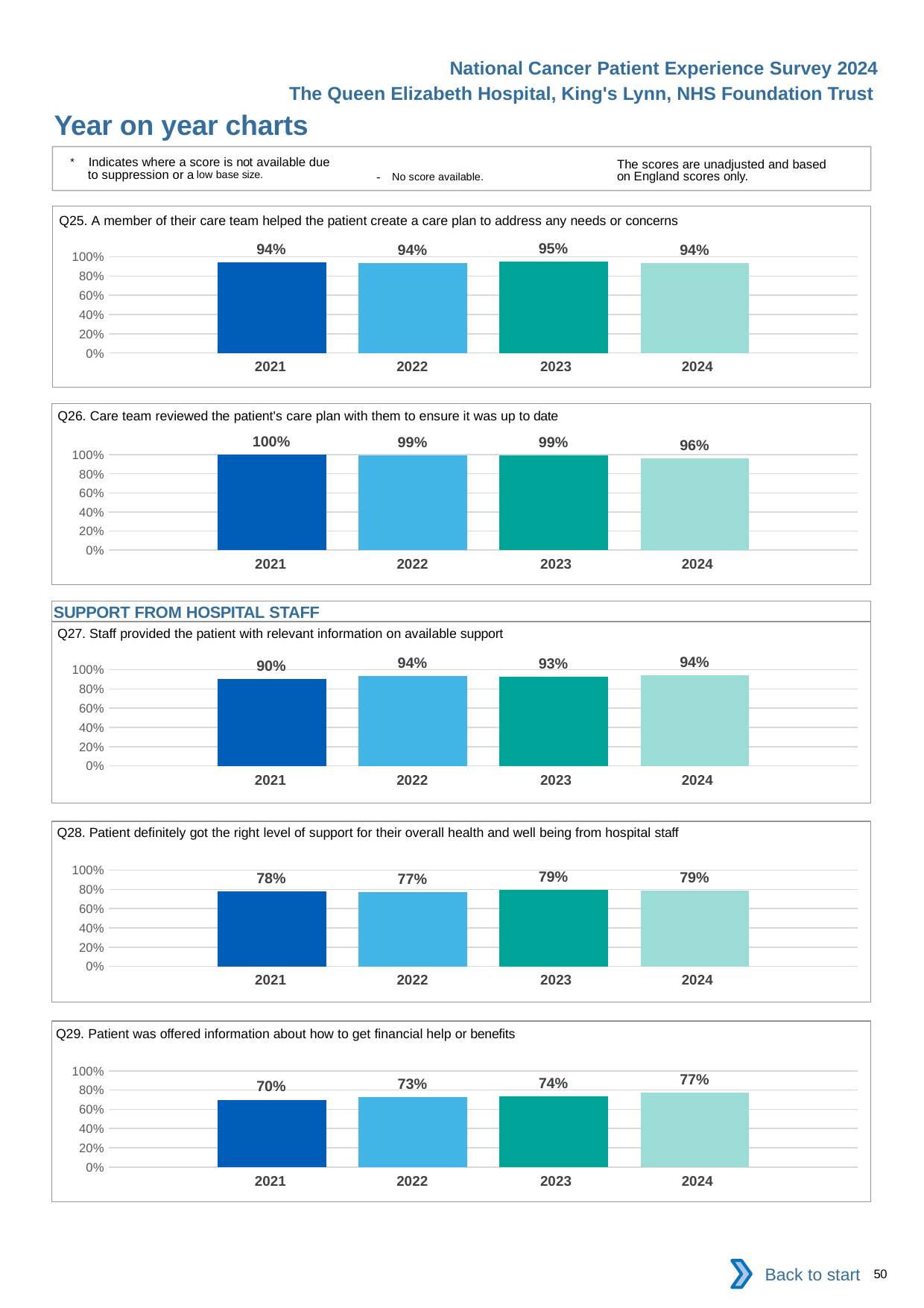
How many years are shown in the Q25 chart? 4 In the Q28 chart, what is the value for 2022? 77% In the Q27 chart, which year has the lowest value? 2021 In the Q25 chart, what is the value for 2023? 95% In the Q29 chart, do the values rise or fall from 2021 to 2024? rise In the Q26 chart, what is the value for 2021? 100% What kind of chart is the Q28 chart? bar chart In the Q29 chart, what is the difference between the 2024 value and the 2021 value? 7% In the Q28 chart, is the value for 2021 greater or less than 80%? less In the Q29 chart, which year has the highest value? 2024 In the Q26 chart, which year has the lowest value? 2024 In the Q27 chart, what is the difference between the 2022 value and the 2021 value? 4%